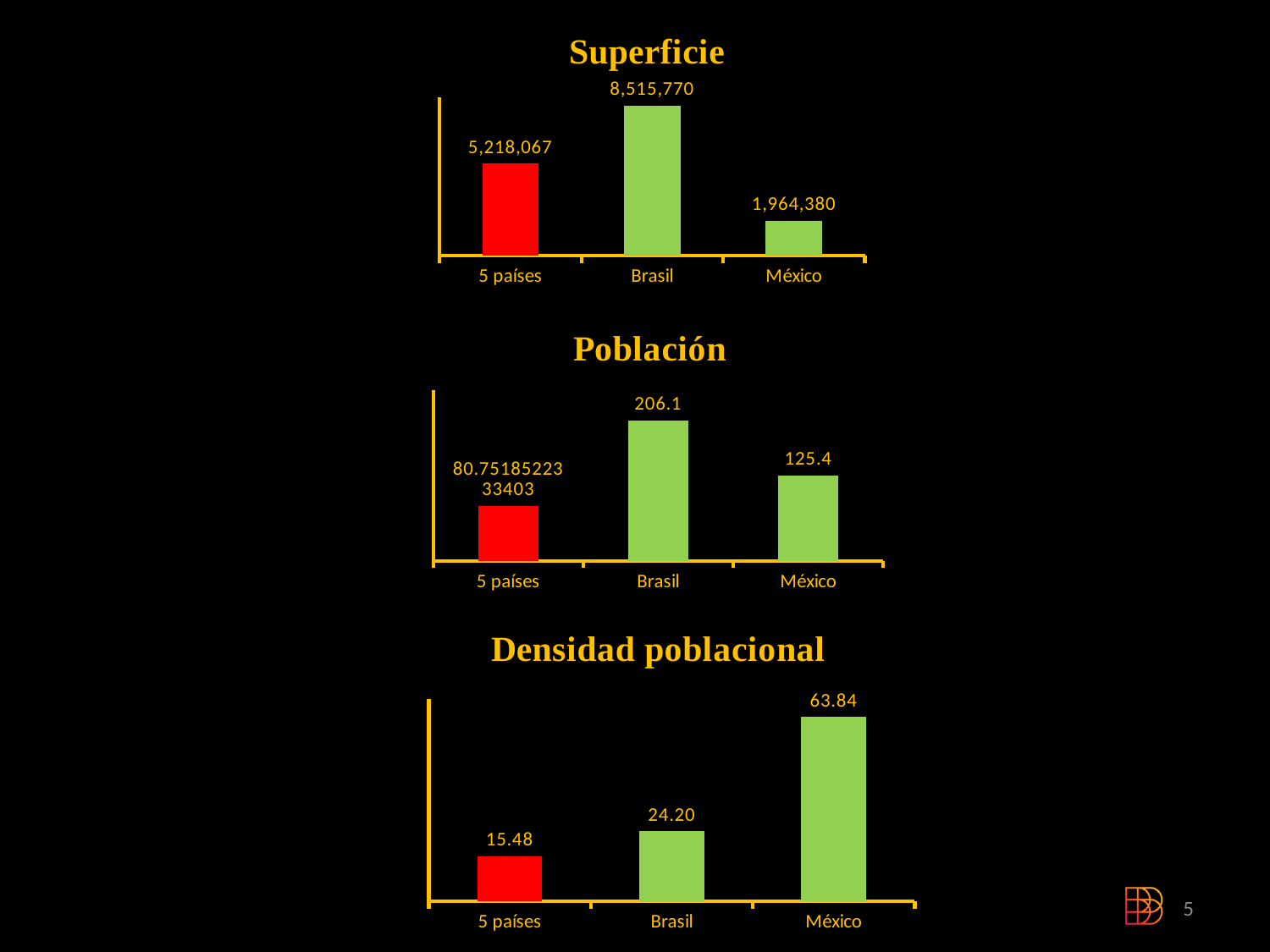
In the Superficie chart, what is the value for Brasil? 8,515,770 In the Densidad poblacional chart, what colour is the bar for 5 países? red What kind of chart is the Población chart? bar chart How many categories does the Superficie chart show? 3 In the Superficie chart, which category has the lowest value? México In the Densidad poblacional chart, which is larger, the value for Brasil or the value for 5 países? Brasil In the Densidad poblacional chart, which category has the highest value? México In the Población chart, which category has the highest value? Brasil In the Densidad poblacional chart, what is the value for 5 países? 15.48 In the Población chart, what is the difference between the values for Brasil and México? 80.7 In the Población chart, what is the value for México? 125.4 In the Superficie chart, what is the difference between the values for Brasil and México? 6,551,390